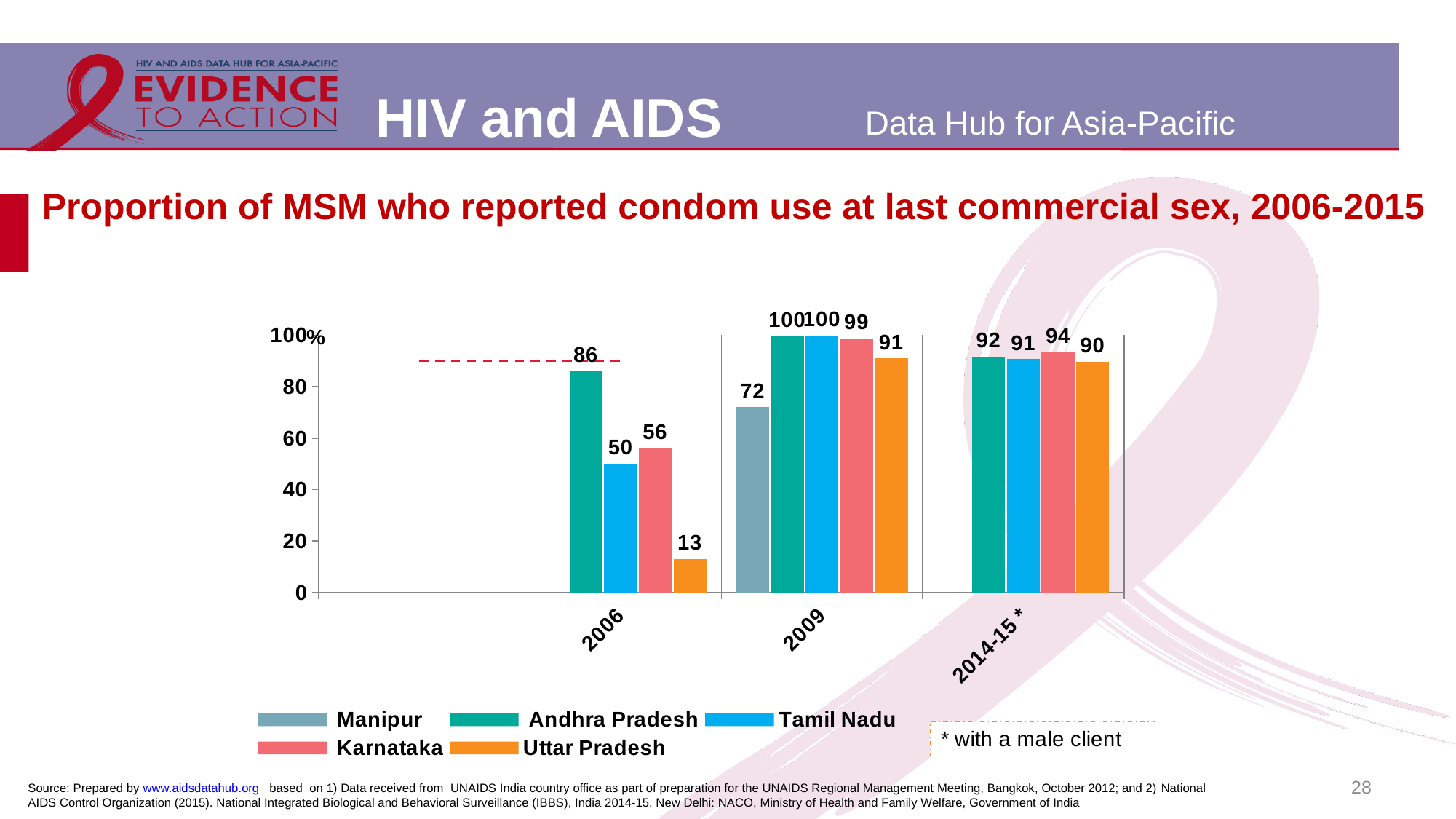
Which was larger in 2006, Karnataka or Tamil Nadu? Karnataka What kind of chart is shown on the slide? Bar chart What was the value for Uttar Pradesh in 2006? 13 Which state had the lowest value in 2006? Uttar Pradesh Which colour represents Tamil Nadu in the legend? Blue Which state had the highest value in 2014-15? Karnataka Did the value for Uttar Pradesh rise or fall from 2006 to 2009? Rise How many series does the legend list? 5 What was the value for Manipur in 2009? 72 How many year categories are shown on the x axis? 3 What is the difference between Andhra Pradesh and Tamil Nadu in 2006? 36 What was the value for Karnataka in 2014-15? 94